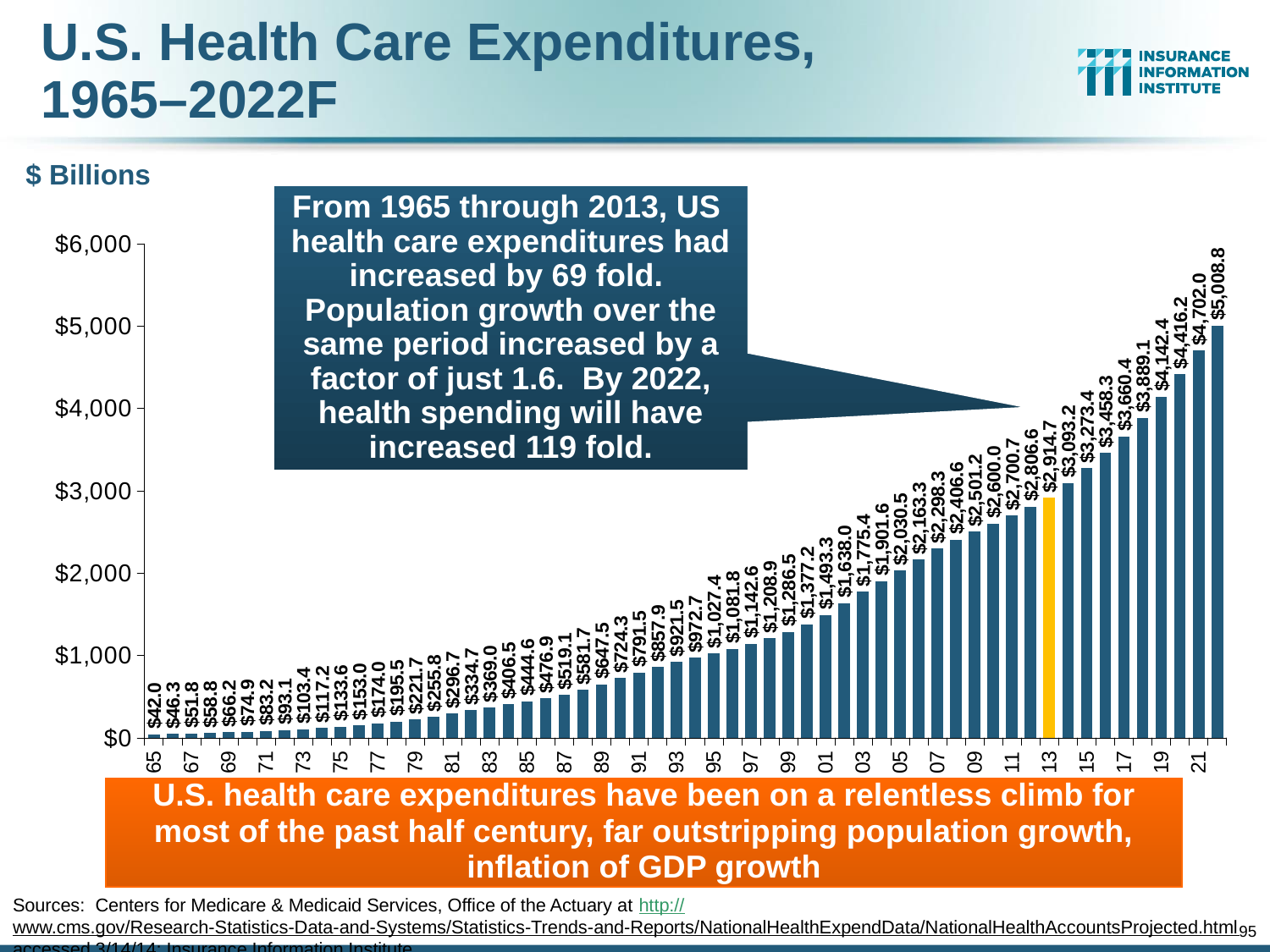
How many bars (years) are plotted in the chart? 58 Which year has the highest value? 2022 ($5,008.8) What is the value for 1985? $444.6 What is the difference between the 2022 value and the 2013 value? $2,094.1 Is the value for 2010 greater or less than $2,000? greater What kind of chart is shown on the slide? Bar chart Which year has the lowest value? 1965 ($42.0) Which is larger, the value for 1995 or the value for 2005? 2005 What is the value for 2000? $1,377.2 What is the value for 1965? $42.0 What is the value for 2013 (the highlighted bar)? $2,914.7 Do the values rise or fall from 1965 to 2022? Rise